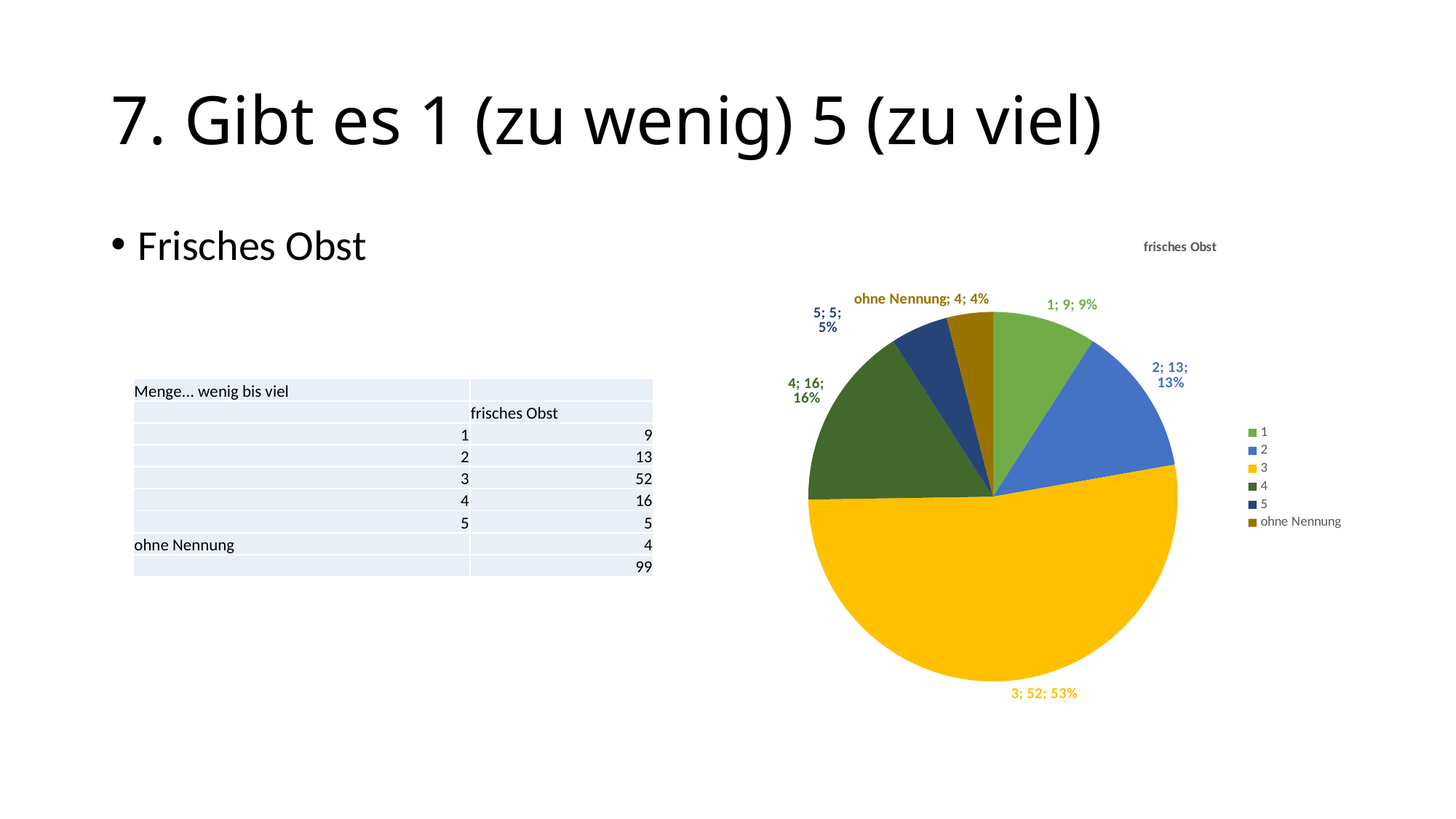
What share of the pie does category 4 represent? 16% What is the value for 'ohne Nennung' in the pie chart? 4 What is the difference between the values for category 3 and category 4? 36 Which category has the smallest slice in the pie chart? ohne Nennung What kind of chart is shown on the slide? pie chart What is the title of the chart? frisches Obst What is the value for category 2 in the pie chart? 13 What share of the pie does category 1 represent? 9% How many slices does the pie chart have? 6 What is the value for category 3 in the pie chart? 52 Which category has the largest slice in the pie chart? 3 Which is larger, the value for category 2 or the value for category 5? 2